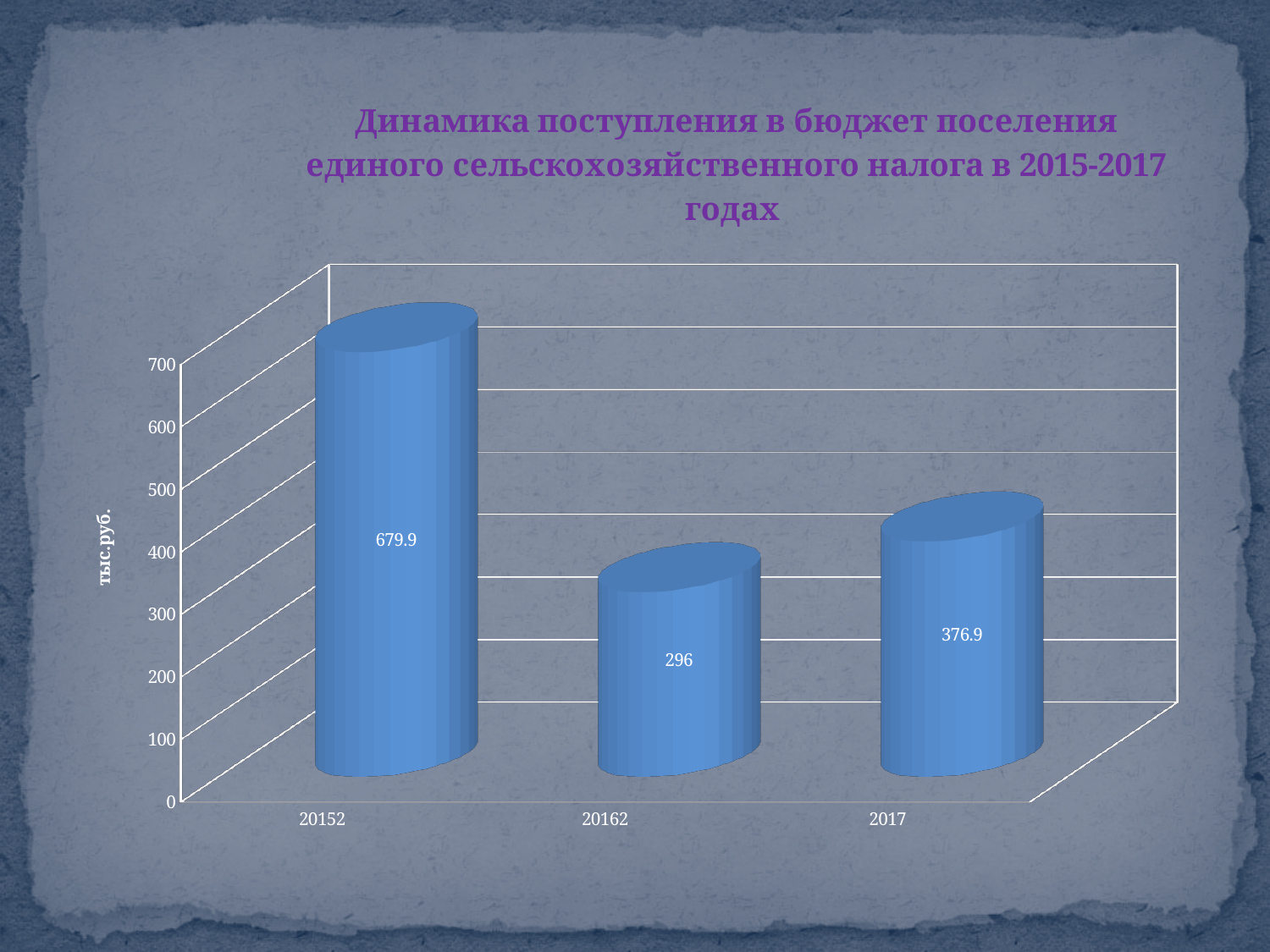
What is the value for 20152? 679.9 Which is larger, the value for 20162 or the value for 2017? 2017 What is the value for 20162? 296 What is the label of the vertical axis? тыс.руб. What is the title of the chart? Динамика поступления в бюджет поселения единого сельскохозяйственного налога в 2015-2017 годах What is the difference between the values for 2017 and 20162? 80.9 Which category has the highest value? 20152 What is the difference between the values for 20152 and 2017? 303 What kind of chart is shown on the slide? bar chart What is the value for 2017? 376.9 How many categories are shown on the x axis? 3 Which category has the lowest value? 20162